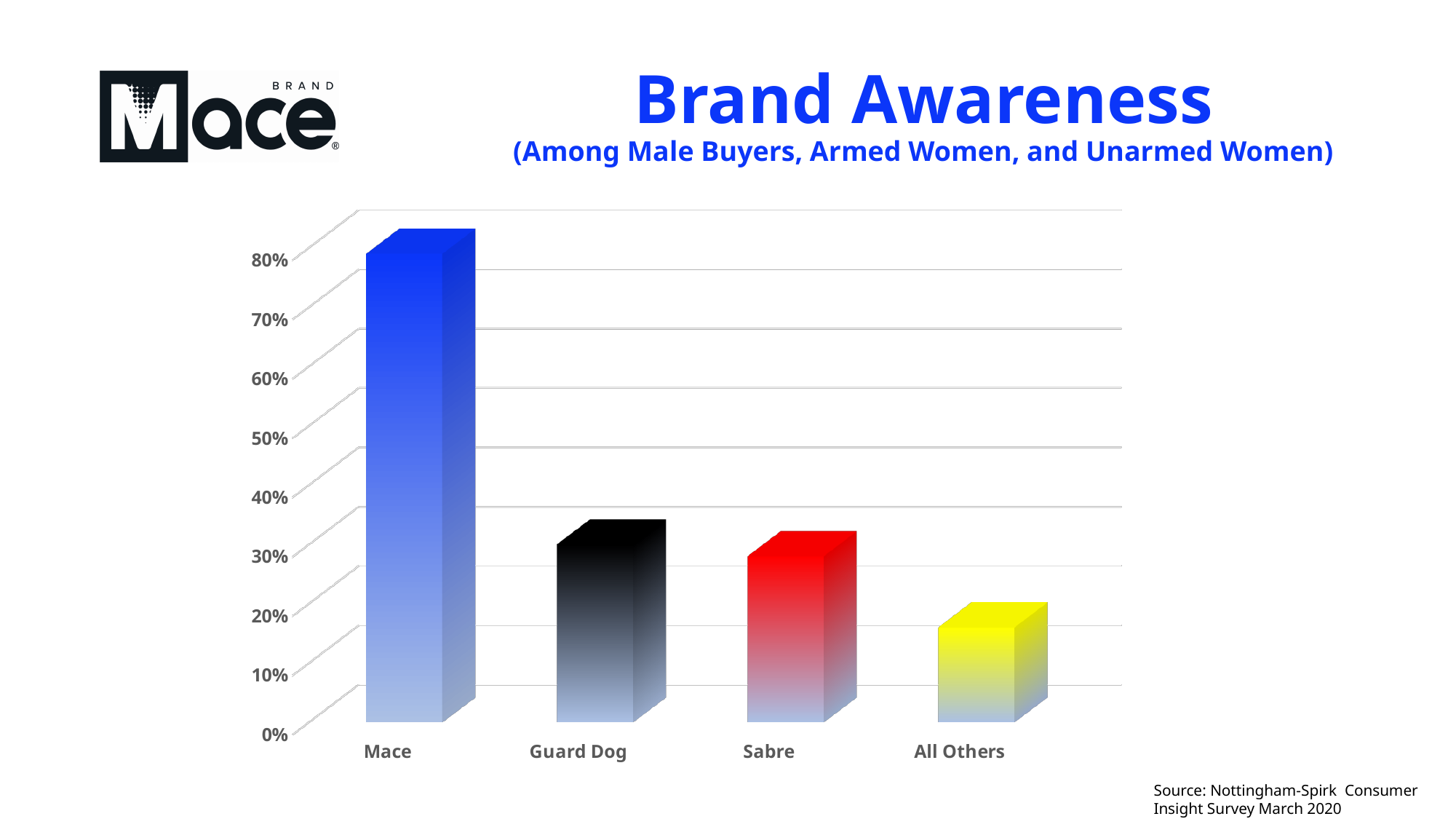
Which has the larger value, Mace or Guard Dog? Mace Is the value for All Others greater or less than 10%? greater What is the title of the chart on the slide? Brand Awareness Is the value for Sabre greater or less than 20%? greater Is the value for Guard Dog greater or less than 40%? less Which has the larger value, Sabre or All Others? Sabre Which category has the lowest brand awareness in the chart? All Others What kind of chart is shown on the slide? bar chart Which brand has the highest brand awareness in the chart? Mace How many brand categories are shown on the x axis of the chart? 4